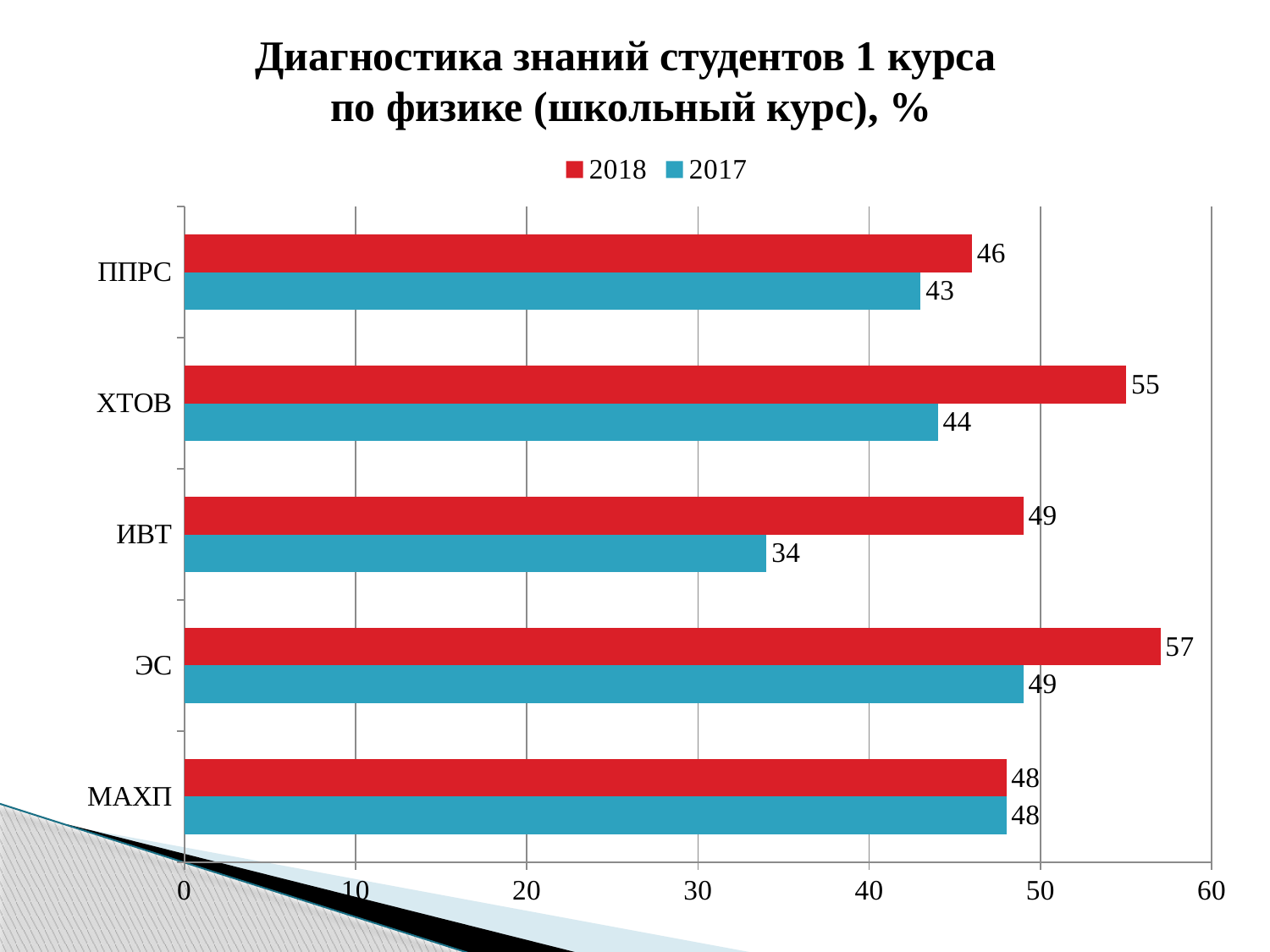
What is the 2018 value for ХТОВ? 55 How many series does the legend list? 2 What is the 2017 value for ППРС? 43 What is the 2017 value for ИВТ? 34 How many categories are shown on the chart? 5 Which category has the highest 2018 value? ЭС Which is larger, the 2017 value for ЭС or the 2017 value for ХТОВ? ЭС What is the difference between the 2018 values for ЭС and ППРС? 11 Which category has the lowest 2017 value? ИВТ Which colour represents the 2017 series? blue What kind of chart is shown on the slide? bar chart What is the difference between the 2018 and 2017 values for ИВТ? 15